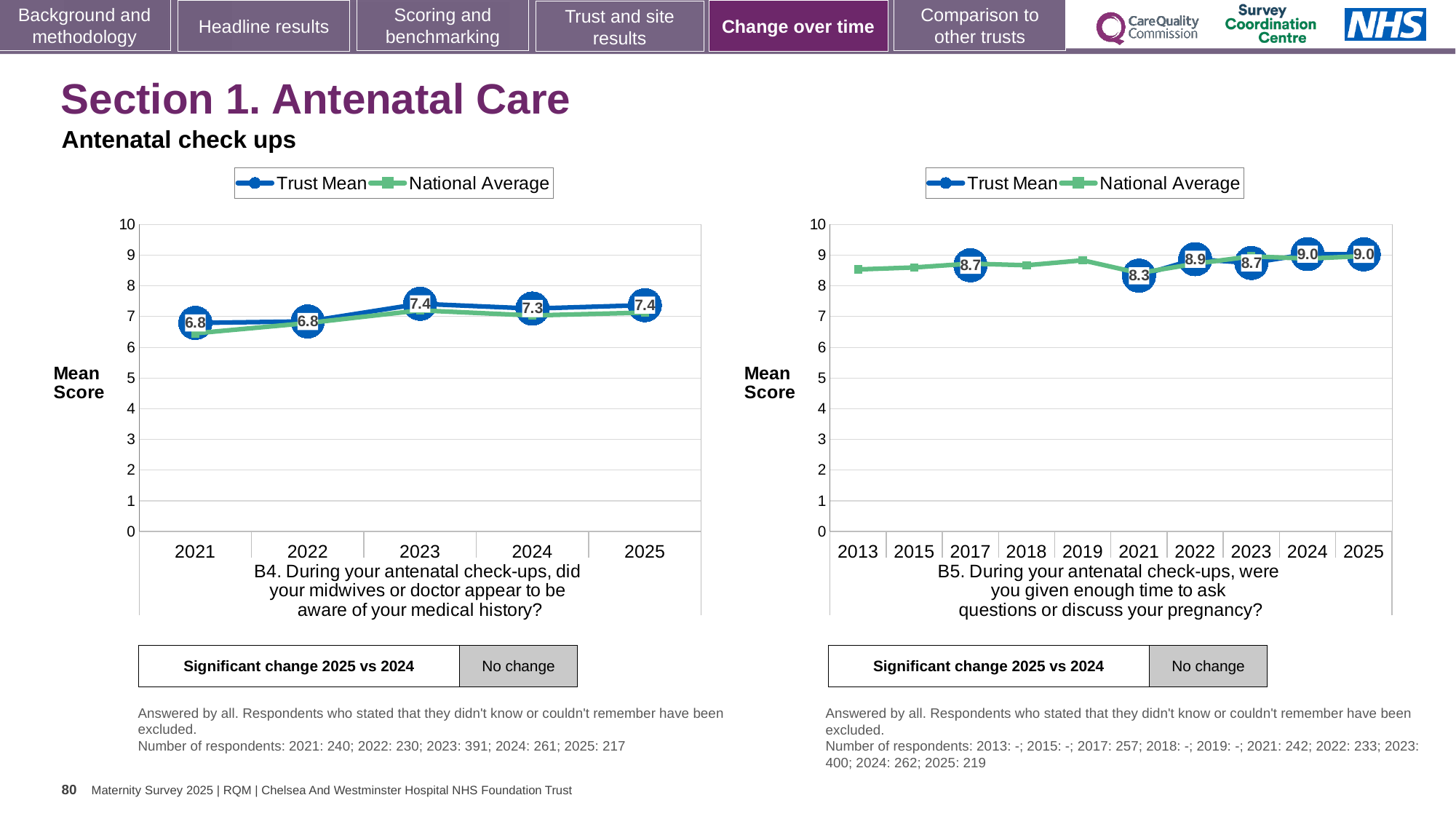
What type of chart is the left chart (B4)? Line chart How many series does the legend of the left chart (B4) list? 2 In the right chart (B5), is the National Average value for 2019 greater or less than 8? greater In the right chart (B5), which year has the lowest labelled Trust Mean score? 2021 In the left chart (B4), what is the difference between the Trust Mean score in 2025 and in 2021? 0.6 In the right chart (B5), what is the difference between the Trust Mean score in 2022 and in 2021? 0.6 In the left chart (B4), what is the Trust Mean score for 2021? 6.8 In the left chart (B4), what is the Trust Mean score for 2023? 7.4 In the left chart (B4), is the Trust Mean score higher in 2023 or in 2024? 2023 In the right chart (B5), what is the Trust Mean score for 2025? 9.0 How many years are shown on the x axis of the right chart (B5)? 10 In the right chart (B5), what is the Trust Mean score for 2021? 8.3